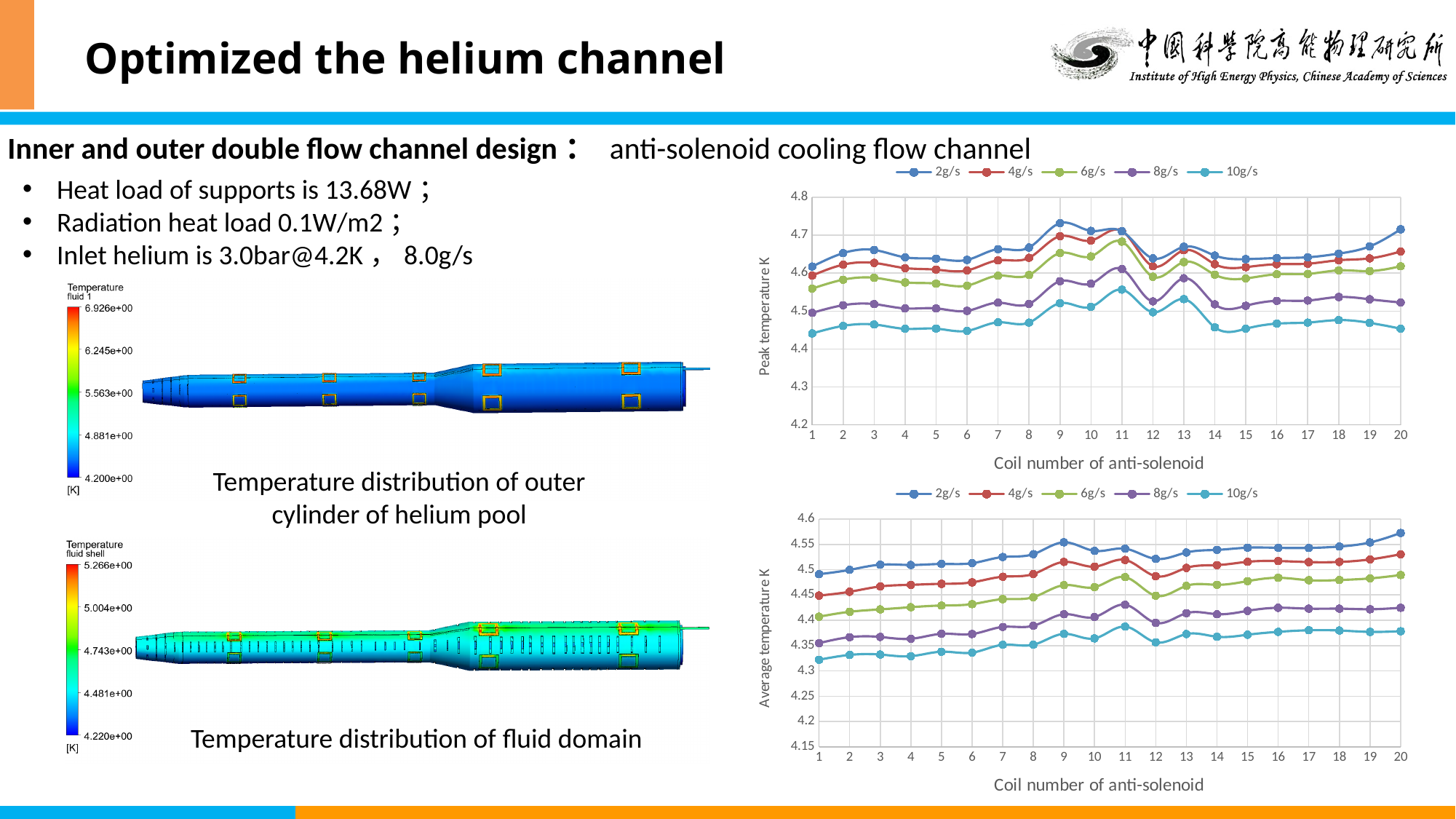
In the bottom chart (Average temperature K), does the 2g/s series generally rise or fall from coil 1 to coil 20? rise In the bottom chart (Average temperature K), is the value for 10g/s at coil 1 greater or less than 4.35? less In the bottom chart (Average temperature K), which series has the lowest average temperature across the coils? 10g/s In the top chart (Peak temperature K), which is larger at coil 11: the value for 6g/s or the value for 10g/s? 6g/s In the top chart (Peak temperature K), is the value for 2g/s at coil 9 greater or less than 4.7? greater In the top chart (Peak temperature K), how many coil numbers are shown on the x axis? 20 In the top chart (Peak temperature K), how many series does the legend list? 5 In the bottom chart (Average temperature K), is the value for 2g/s at coil 20 greater or less than 4.55? greater In the top chart (Peak temperature K), which series has the highest peak temperature across the coils? 2g/s What is the x-axis title of the bottom chart (Average temperature K)? Coil number of anti-solenoid What kind of chart is the bottom chart (Average temperature K)? line chart